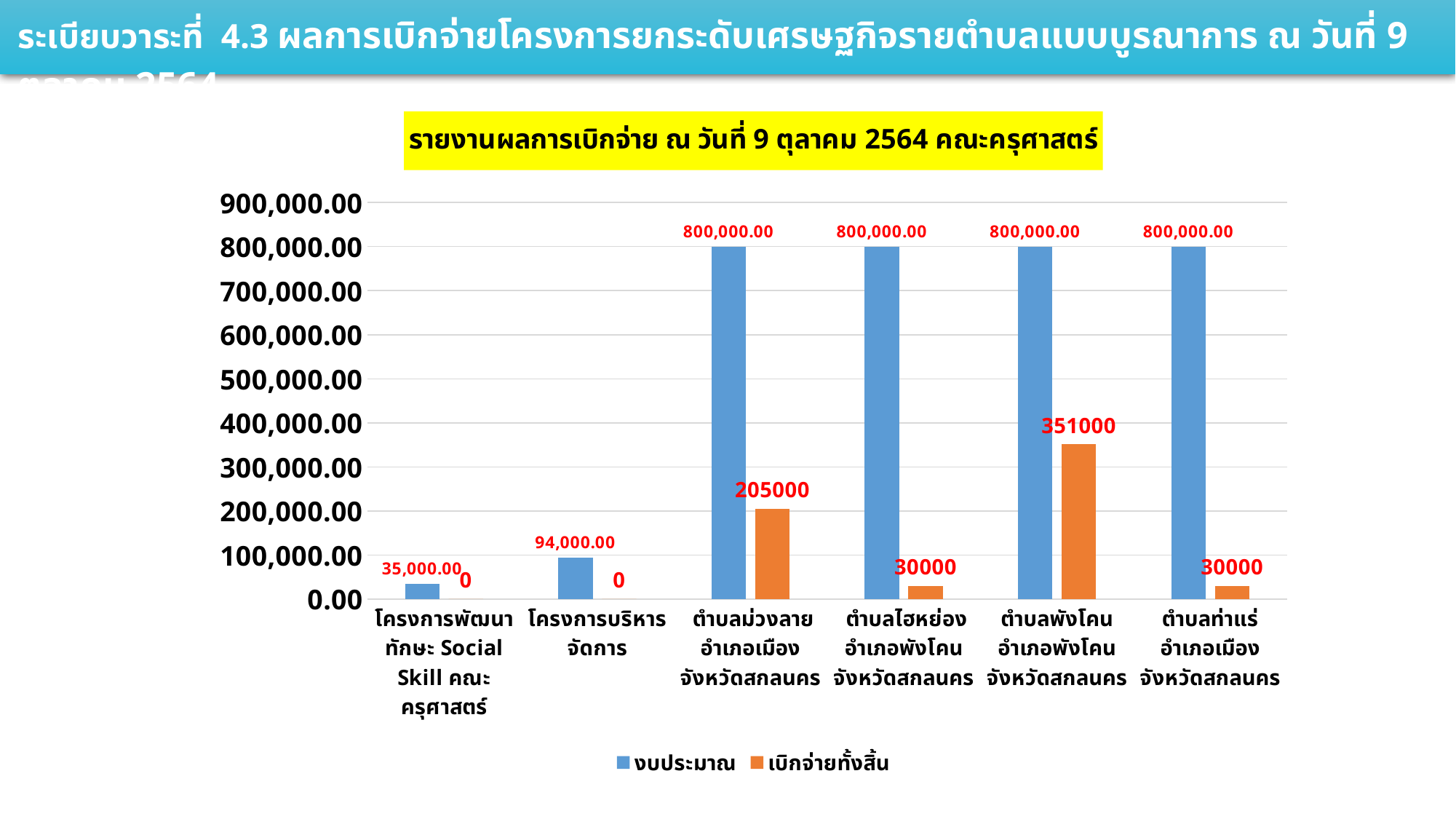
What is the งบประมาณ value for โครงการพัฒนาทักษะ Social Skill คณะครุศาสตร์? 35,000.00 Which category has the lowest งบประมาณ value? โครงการพัฒนาทักษะ Social Skill คณะครุศาสตร์ What kind of chart is shown on the slide? Bar chart What is the งบประมาณ value for โครงการบริหารจัดการ? 94,000.00 What is the เบิกจ่ายทั้งสิ้น value for ตำบลไฮหย่อง อำเภอพังโคน จังหวัดสกลนคร? 30000 How many categories are shown on the x axis? 6 What is the title of the chart? รายงานผลการเบิกจ่าย ณ วันที่ 9 ตุลาคม 2564 คณะครุศาสตร์ Which is larger: the เบิกจ่ายทั้งสิ้น value for ตำบลม่วงลาย or for ตำบลท่าแร่? ตำบลม่วงลาย How many series does the legend list? 2 What is the เบิกจ่ายทั้งสิ้น value for ตำบลม่วงลาย อำเภอเมือง จังหวัดสกลนคร? 205000 Which category has the highest เบิกจ่ายทั้งสิ้น value? ตำบลพังโคน อำเภอพังโคน จังหวัดสกลนคร What is the difference between the งบประมาณ and เบิกจ่ายทั้งสิ้น values for ตำบลพังโคน อำเภอพังโคน จังหวัดสกลนคร? 449,000.00